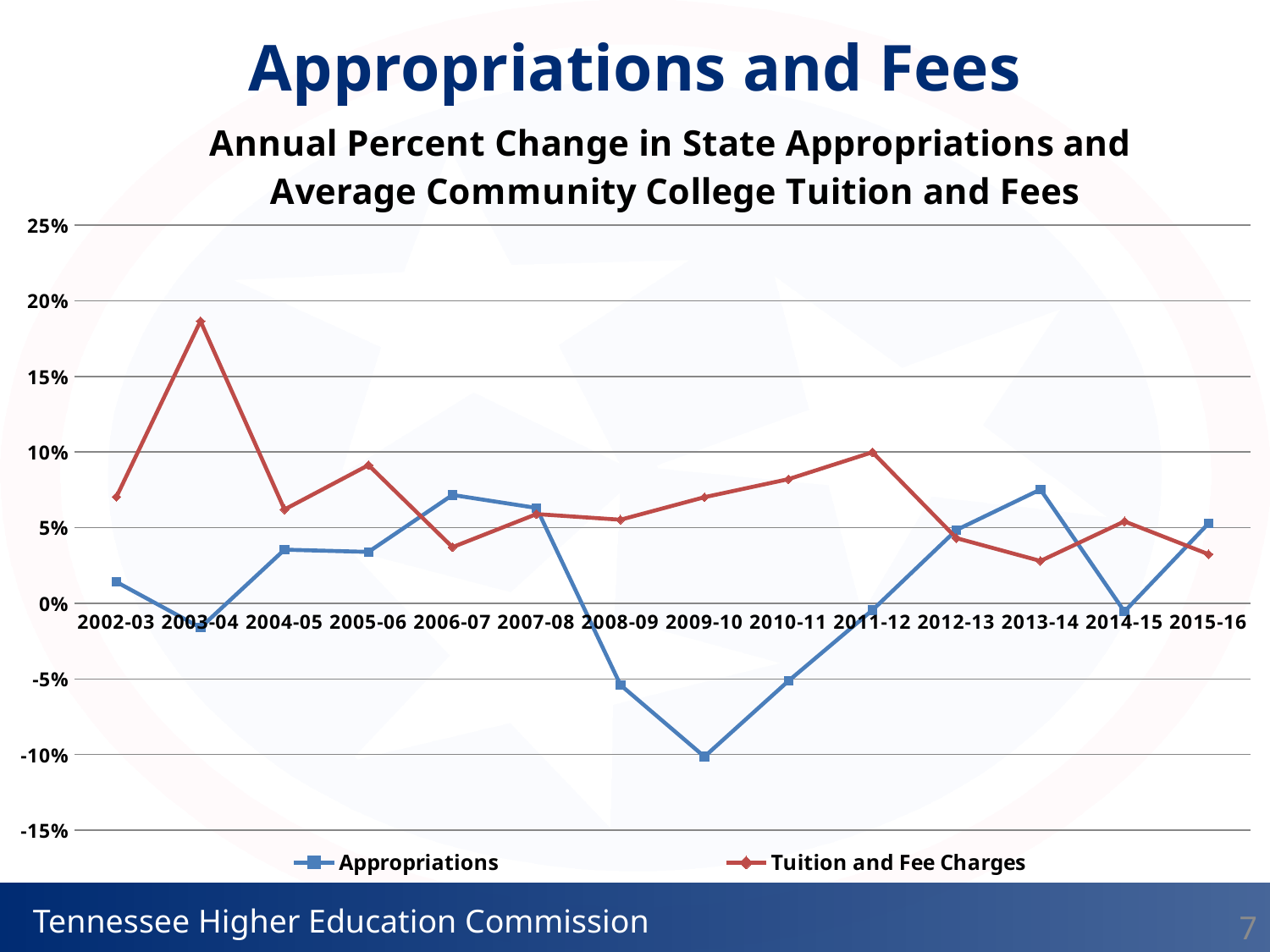
In 2013-14, which series has the larger value, Appropriations or Tuition and Fee Charges? Appropriations Is the value for Appropriations in 2013-14 greater or less than 5%? greater Is the value for Appropriations in 2009-10 greater or less than -5%? less Is the value for Tuition and Fee Charges in 2003-04 greater or less than 15%? greater In which year does the Appropriations series reach its lowest value? 2009-10 What kind of chart is shown on the slide? Line chart In which year does the Tuition and Fee Charges series reach its highest value? 2003-04 In 2009-10, which series has the larger value, Appropriations or Tuition and Fee Charges? Tuition and Fee Charges Does the Appropriations series rise or fall from 2009-10 to 2011-12? Rise How many series does the legend list? 2 How many academic years are plotted along the x axis? 14